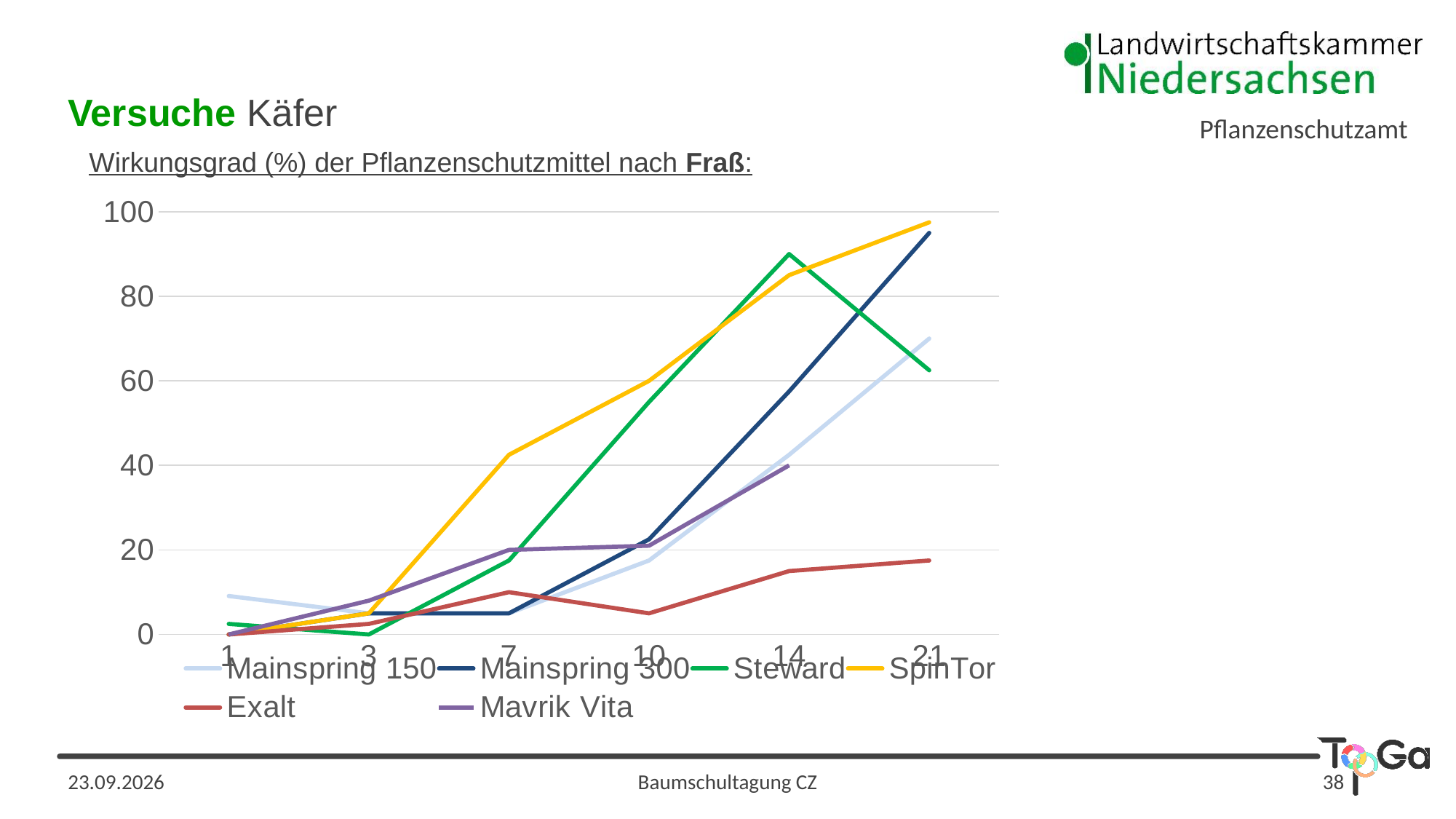
Which series has the highest value at x = 7? SpinTor Which series has the lowest value at x = 21? Exalt What kind of chart is shown on the slide? line chart Does the Steward line rise or fall between x = 14 and x = 21? fall Is the value for Mainspring 150 at x = 21 greater or less than 60? greater Is the value for SpinTor at x = 10 greater or less than 40? greater Is the value for Exalt at x = 21 greater or less than 20? less At x = 10, which is larger: SpinTor or Mainspring 300? SpinTor How many series does the legend list? 6 How many points are marked on the x axis? 6 Which series in the legend is drawn in yellow? SpinTor